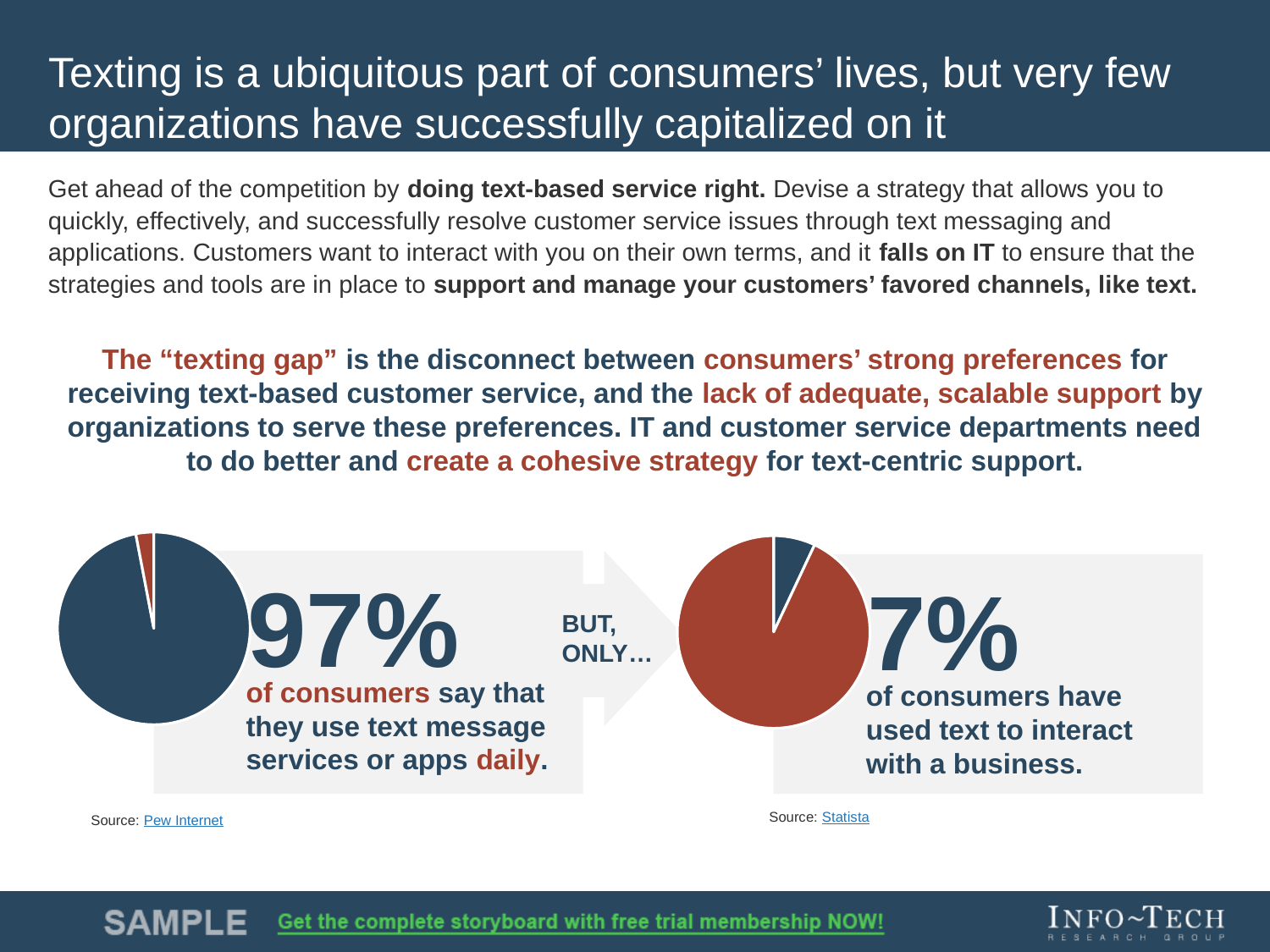
How many slices does the left pie chart have? 2 In the right pie chart, which slice is larger, the dark blue slice or the red slice? the red slice Which is larger: the share of consumers who use text message services daily (left chart) or the share who have used text to interact with a business (right chart)? consumers who use text message services daily (97%) How many charts are shown on the slide? 2 What kind of chart is the left chart on the slide? pie chart What is the difference between the 97% shown in the left pie chart and the 7% shown in the right pie chart? 90 percentage points In the left pie chart, which slice is larger, the dark blue slice or the red slice? the dark blue slice Is the value highlighted in the right pie chart greater or less than 50%? less How many slices does the right pie chart have? 2 What source is cited for the left pie chart? Pew Internet In the right pie chart, what percentage of consumers have used text to interact with a business? 7% In the left pie chart, what percentage of consumers say they use text message services or apps daily? 97%